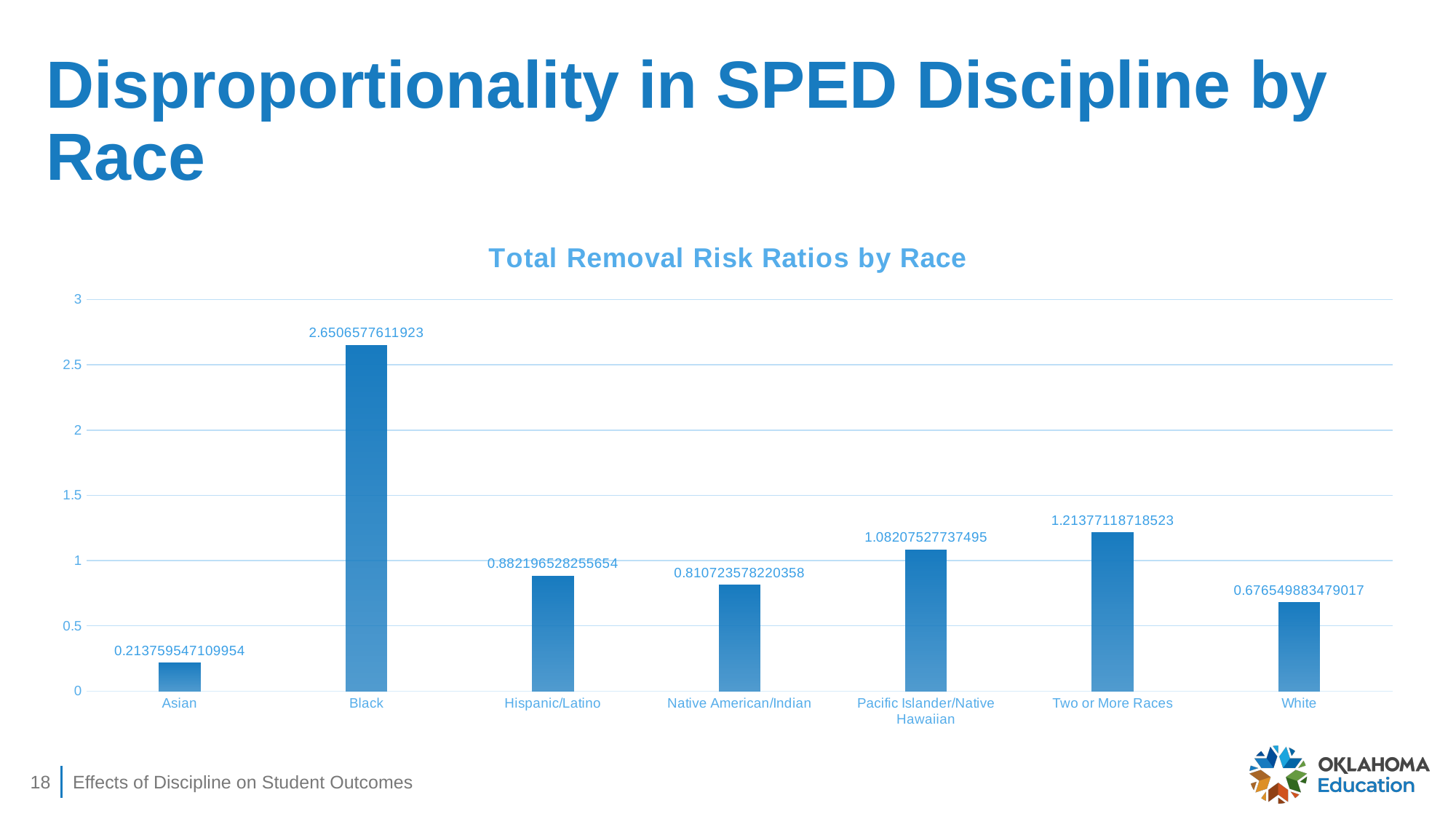
What is the total removal risk ratio for Black students? 2.6506577611923 What is the total removal risk ratio for Asian students? 0.213759547109954 What is the total removal risk ratio for White students? 0.676549883479017 What is the total removal risk ratio for Two or More Races? 1.21377118718523 Which race category has the highest total removal risk ratio? Black Which has a higher total removal risk ratio, Hispanic/Latino or Native American/Indian? Hispanic/Latino What is the difference between the total removal risk ratios for Black and Asian students? 2.436898214082346 Which race category has the lowest total removal risk ratio? Asian What is the title of the chart? Total Removal Risk Ratios by Race What type of chart is shown on the slide? Bar chart How many race categories are plotted in the chart? 7 Is the total removal risk ratio for Pacific Islander/Native Hawaiian greater or less than 1? greater